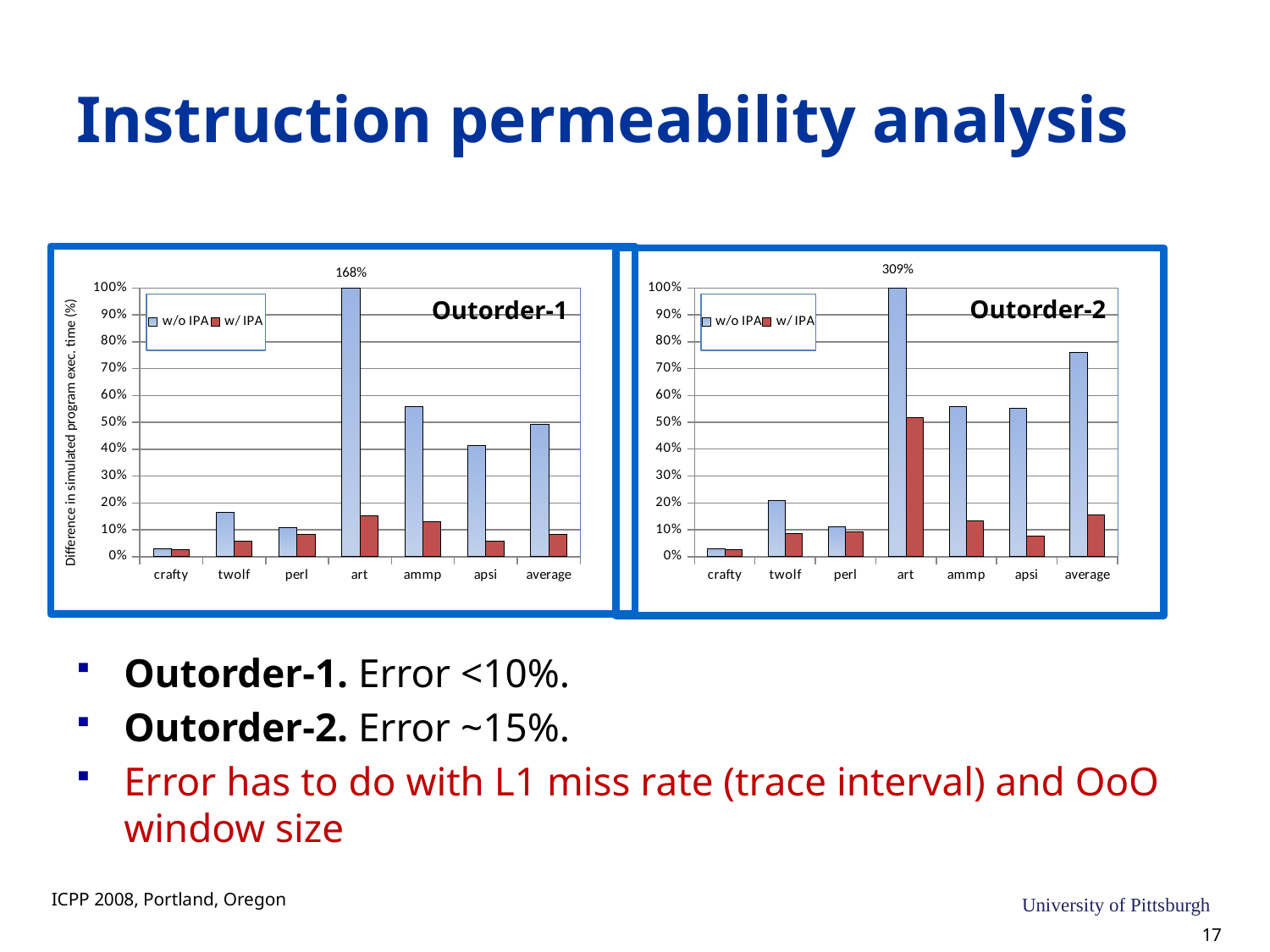
In the Outorder-2 chart, is the w/o IPA value for average greater or less than 70%? greater In the Outorder-2 chart, which category has the highest w/ IPA value? art How many series does the legend of the Outorder-2 chart list? 2 In the Outorder-1 chart, which category has the highest w/o IPA value? art In the Outorder-2 chart, what is the labelled value for art in the w/o IPA series? 309% In the Outorder-1 chart, what is the labelled value for art in the w/o IPA series? 168% In the Outorder-2 chart, is the w/ IPA value for average greater or less than 20%? less In the Outorder-1 chart, is the w/o IPA value for ammp greater or less than 50%? greater In the Outorder-1 chart, which is larger for apsi: the w/o IPA value or the w/ IPA value? w/o IPA In the Outorder-2 chart, which category has the lowest w/o IPA value? crafty What kind of chart is the Outorder-1 chart? Bar chart How many categories are shown on the x axis of the Outorder-1 chart? 7